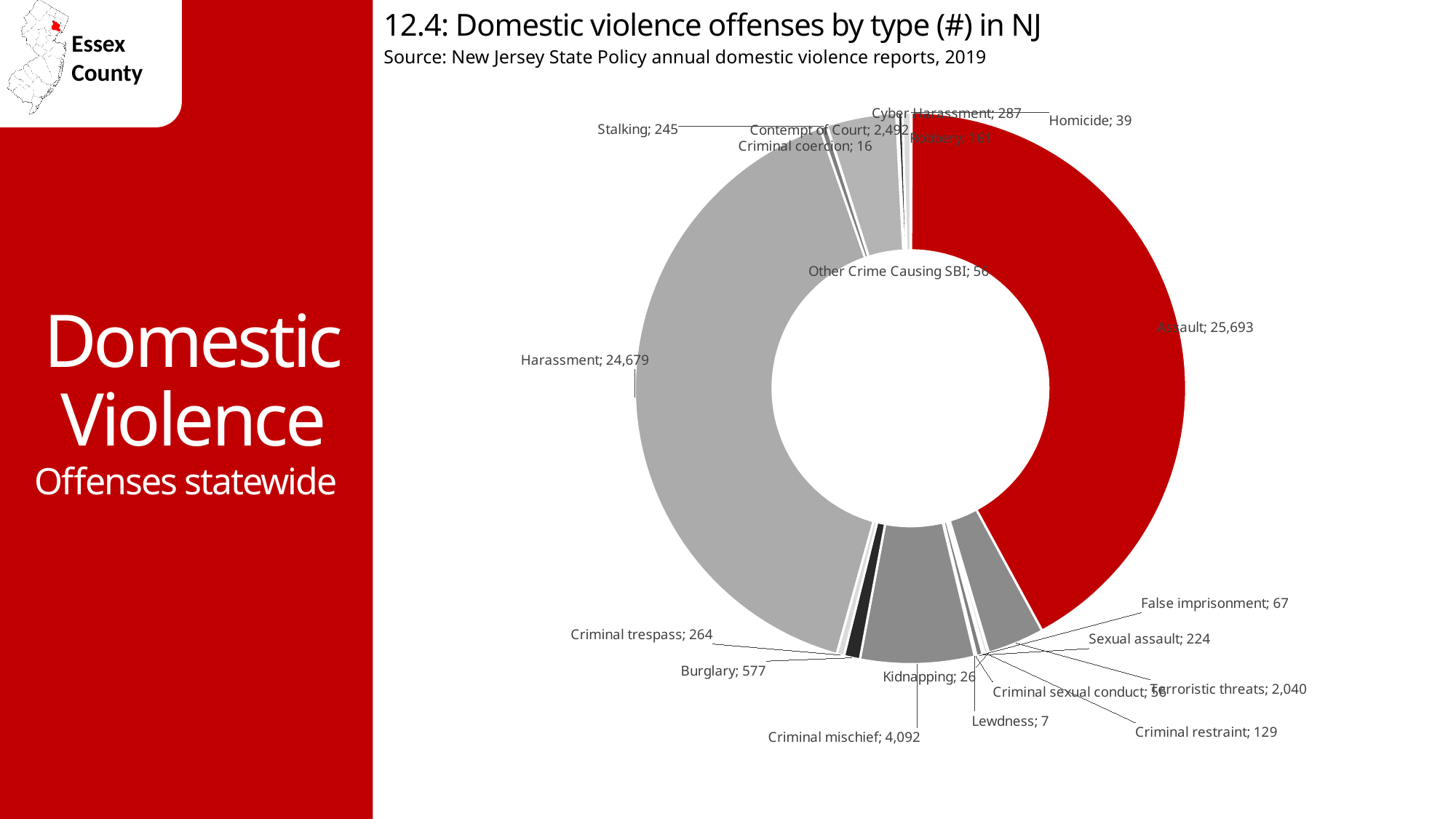
What is the title of the chart? 12.4: Domestic violence offenses by type (#) in NJ What is the value shown for Homicide? 39 What is the difference between the number of Assault offenses and Harassment offenses? 1,014 How many domestic violence offenses of type Assault are shown on the chart? 25,693 What is the value shown for Burglary? 577 Which offense type has the highest number of offenses? Assault Which has more offenses, Burglary or Criminal trespass? Burglary What is the value shown for Harassment? 24,679 What is the value shown for Criminal mischief? 4,092 What kind of chart is shown on the slide? Doughnut (pie) chart What is the value shown for Terroristic threats? 2,040 Which offense type has the lowest number of offenses? Lewdness